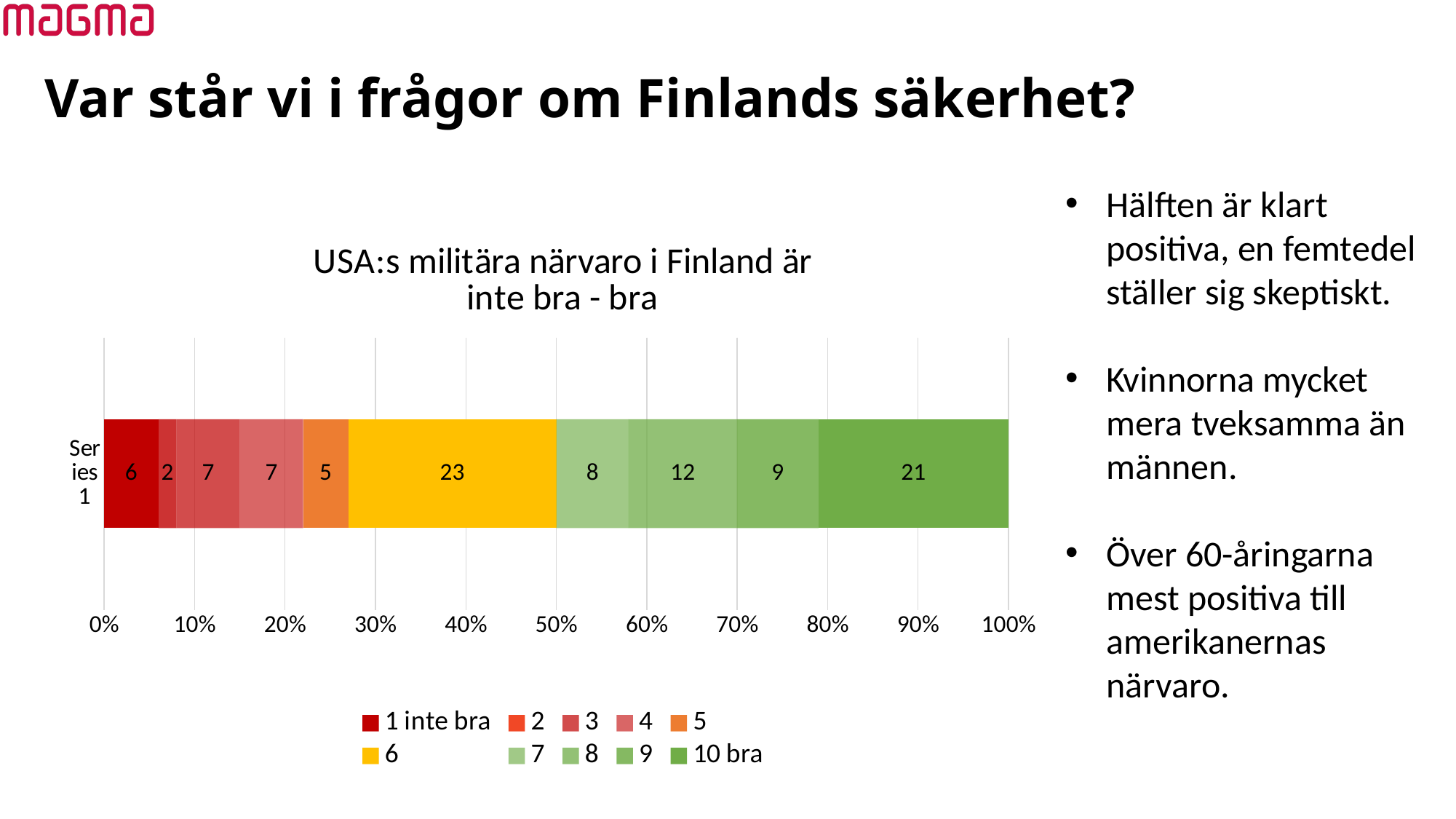
What is the total of all segments in the stacked bar? 100 What is the value for the "6" segment in the chart? 23 Which legend series has the largest segment in the bar? 6 What is the title of the chart? USA:s militära närvaro i Finland är inte bra - bra Which is larger, the "8" segment or the "9" segment? 8 What kind of chart is shown on the slide? Stacked bar chart What is the value for the "1 inte bra" segment in the chart? 6 What is the value for the "8" segment in the chart? 12 How many series does the legend list? 10 What is the difference between the "6" segment and the "10 bra" segment? 2 What is the value for the "10 bra" segment in the chart? 21 Which legend series has the smallest segment in the bar? 2